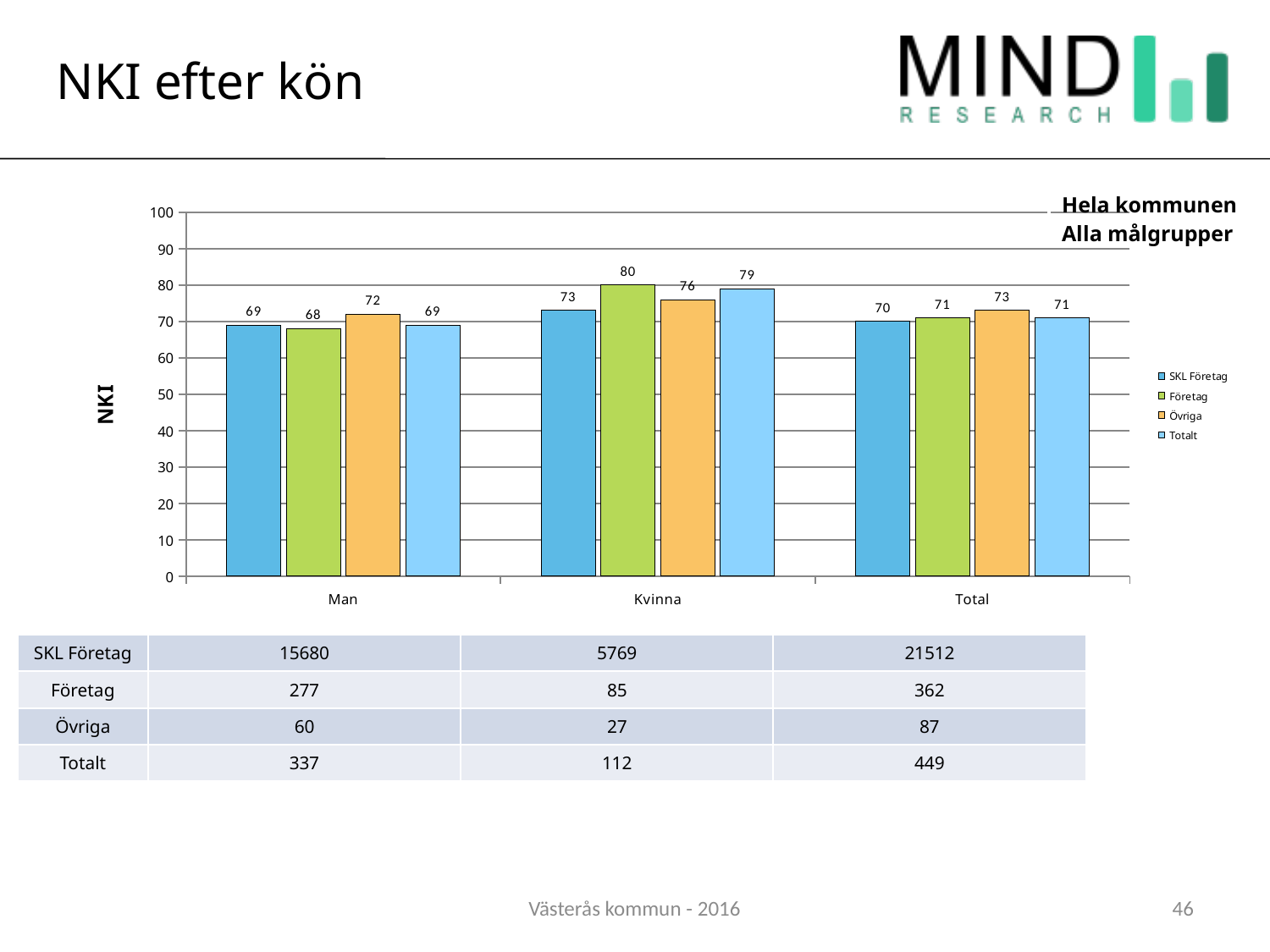
What is the NKI value for Övriga in the Total group? 73 How many series does the legend list? 4 Which series has the lowest NKI value in the Man group? Företag What is the difference between the Totalt NKI value for Kvinna and for Man? 10 What kind of chart is shown on the slide? Bar chart Is the Övriga NKI value higher for Man or for Kvinna? Kvinna Which series has the highest NKI value in the Kvinna group? Företag What is the label of the y axis? NKI How many categories are shown on the x axis? 3 What is the NKI value for Totalt in the Total group? 71 What is the NKI value for SKL Företag in the Man group? 69 What is the NKI value for Företag in the Kvinna group? 80